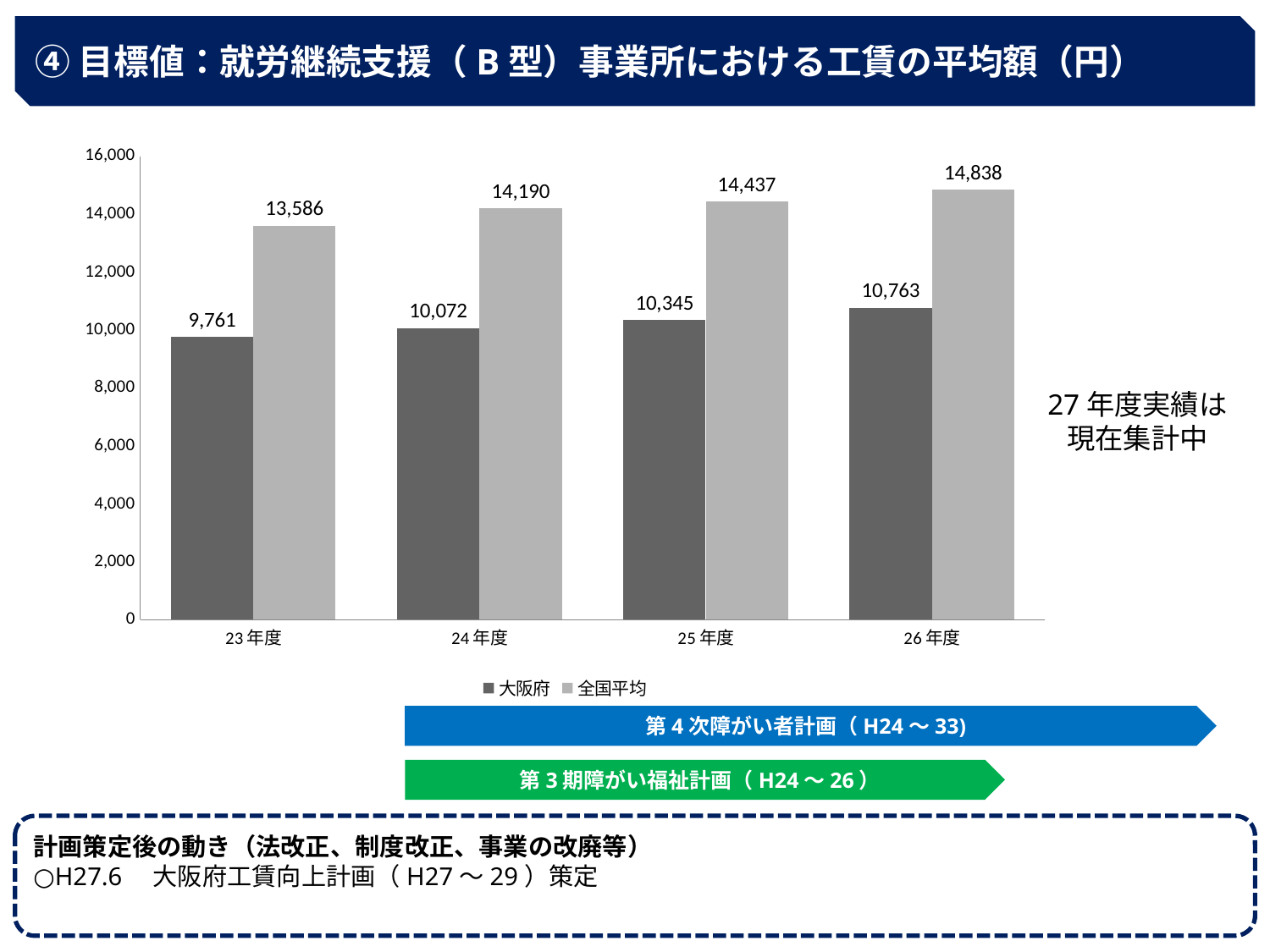
Which is larger in 26年度, 大阪府 or 全国平均? 全国平均 What is the value for 全国平均 in 26年度? 14,838 What is the difference between 全国平均 and 大阪府 in 24年度? 4,118 Do the values for 大阪府 rise or fall from 23年度 to 26年度? rise Which year has the lowest value for 大阪府? 23年度 Is the value for 大阪府 in 26年度 greater or less than 12,000? less What kind of chart is shown on the slide? bar chart What is the value for 大阪府 in 23年度? 9,761 What is the value for 大阪府 in 25年度? 10,345 Which year has the highest value for 全国平均? 26年度 How many series does the legend list? 2 How many years are shown on the x axis? 4